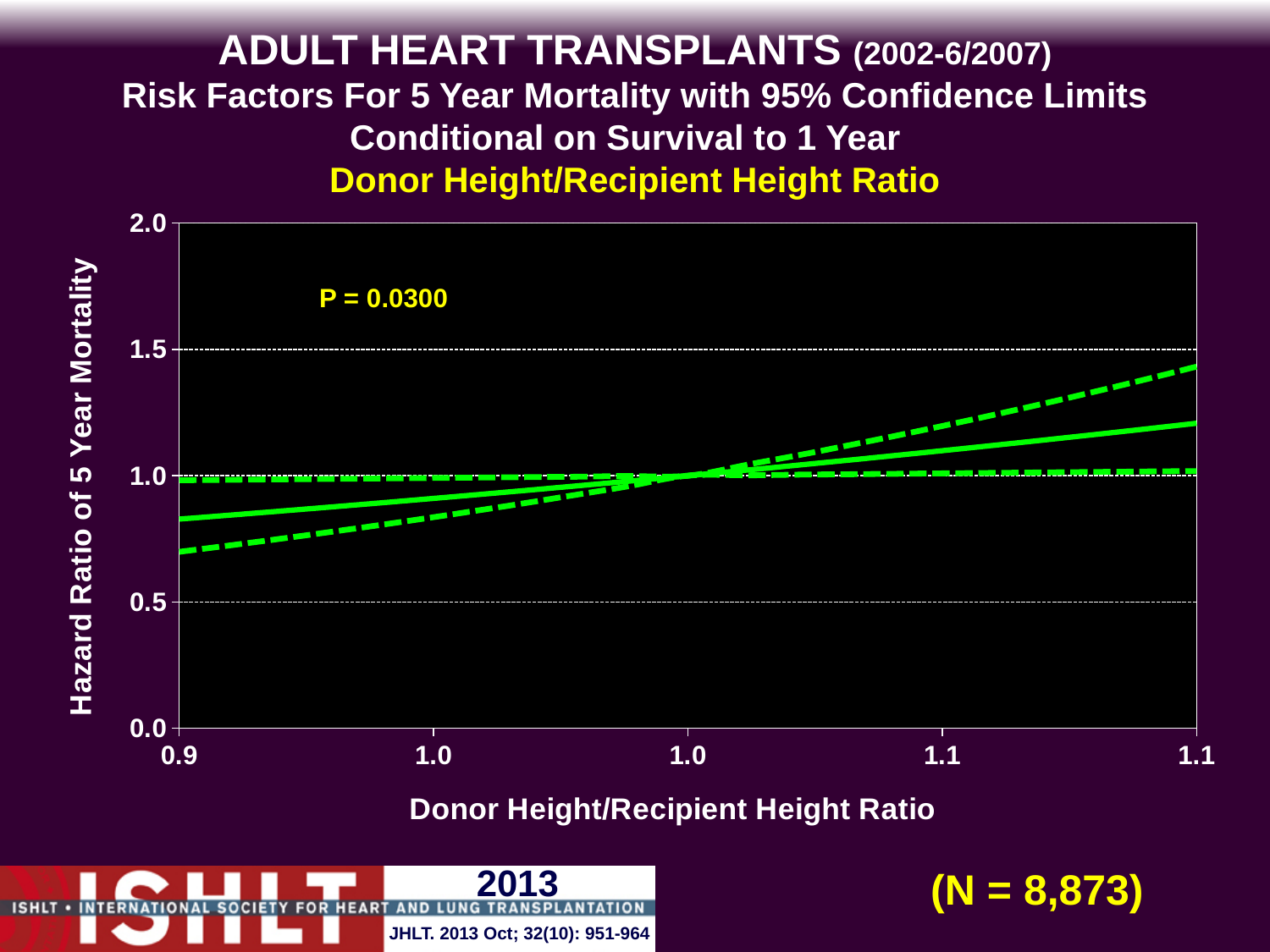
Is the upper dashed confidence limit at the right end of the x axis greater or less than 1.5? less Is the solid hazard ratio line at the right end of the x axis greater or less than 1.5? less Is the lower dashed confidence limit at the left end of the x axis (ratio 0.9) greater or less than 0.5? greater What P value is printed on the chart? P = 0.0300 What is the label of the y axis? Hazard Ratio of 5 Year Mortality How many lines are plotted on the chart? 3 Does the solid hazard ratio line rise or fall as the Donor Height/Recipient Height Ratio increases along the x axis? rise What kind of chart is shown on the slide? line chart